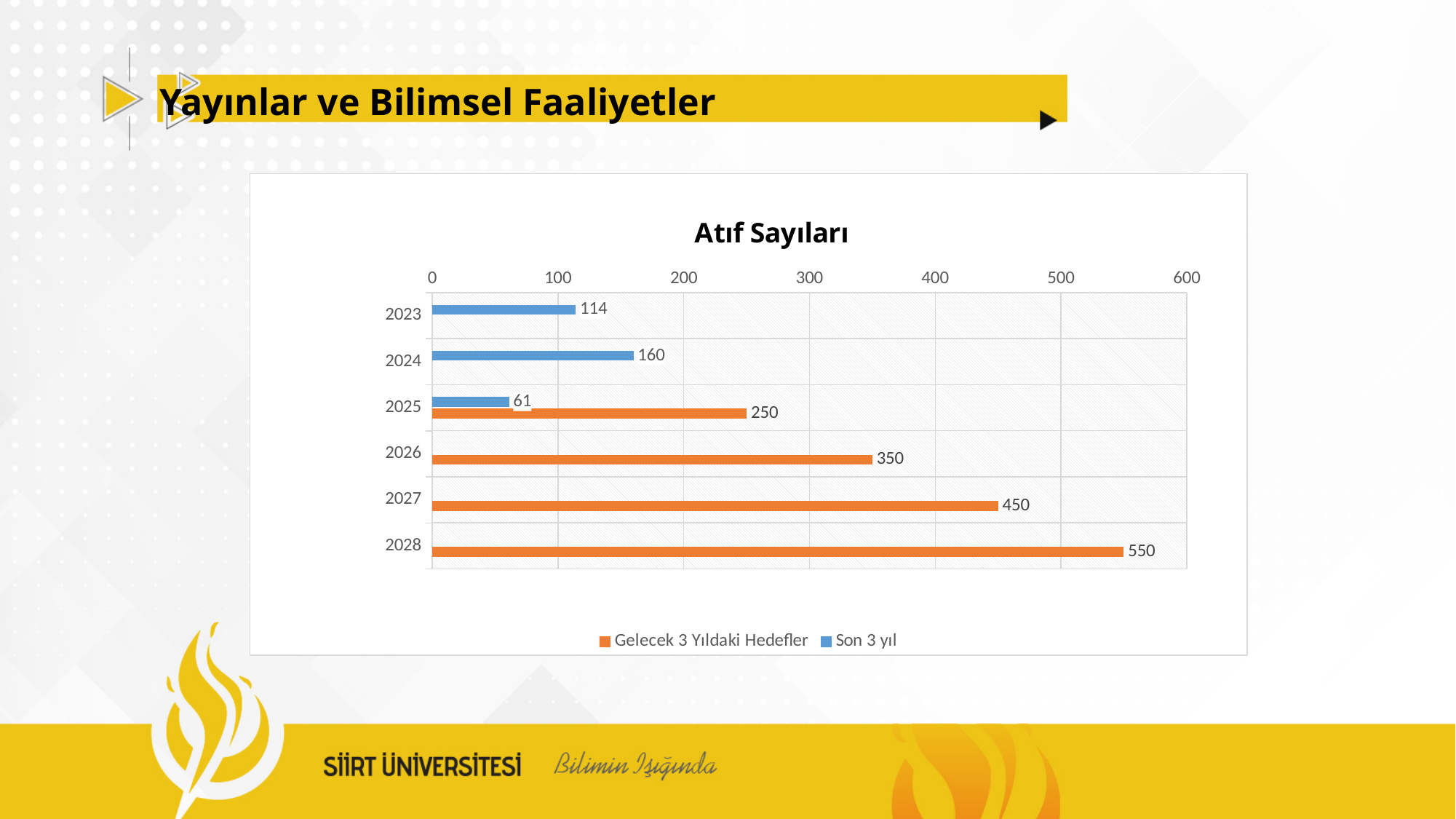
How many years are shown on the vertical axis? 6 What type of chart is shown on the slide? bar chart What is the title of the chart? Atıf Sayıları What is the value for 'Son 3 yıl' in 2024? 160 Do the 'Gelecek 3 Yıldaki Hedefler' values rise or fall from 2025 to 2028? rise Which is larger: the 'Son 3 yıl' value for 2023 or for 2024? 2024 How many series does the legend list? 2 What is the value for 'Son 3 yıl' in 2025? 61 What is the difference between the 'Gelecek 3 Yıldaki Hedefler' values for 2028 and 2026? 200 What is the value for 'Gelecek 3 Yıldaki Hedefler' in 2027? 450 Which year has the lowest value for 'Son 3 yıl'? 2025 Which year has the highest value for 'Gelecek 3 Yıldaki Hedefler'? 2028